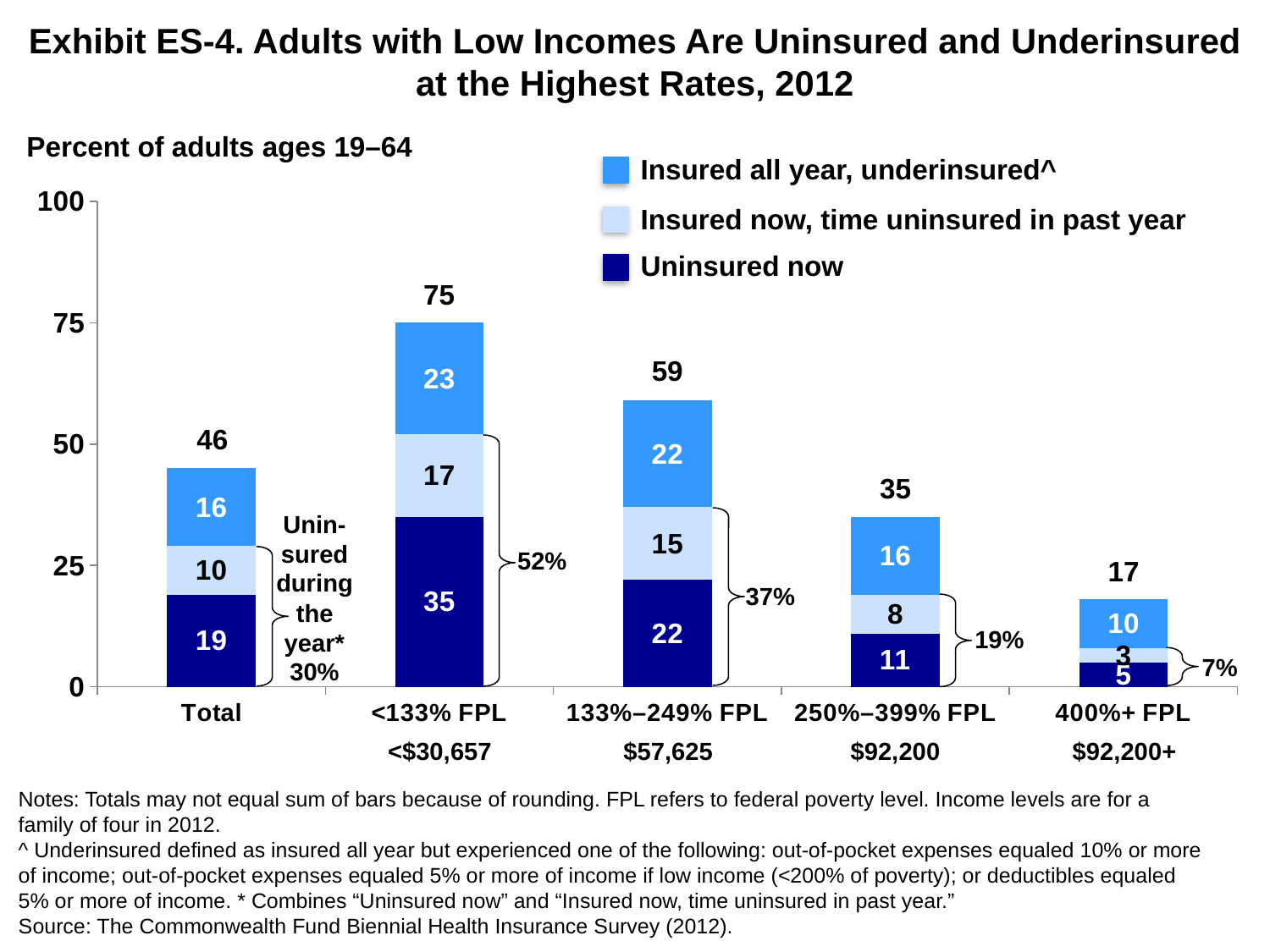
What is the 'Insured all year, underinsured' value for the 133%–249% FPL group? 22 Is the 'Insured all year, underinsured' value larger for the <133% FPL group or the 250%–399% FPL group? <133% FPL What is the 'Uninsured now' value for the <133% FPL group? 35 How many series does the legend list? 3 What percentage is labeled as 'Uninsured during the year' for the 133%–249% FPL group? 37% What total is printed above the bar for the 400%+ FPL group? 17 What is the difference between the 'Uninsured now' values for the <133% FPL group and the Total group? 16 What is the 'Insured now, time uninsured in past year' value for the 250%–399% FPL group? 8 What kind of chart is shown on the slide? Stacked bar chart Which income group has the lowest 'Uninsured now' value? 400%+ FPL Which income group has the highest total bar? <133% FPL How many income categories are shown on the x axis? 5